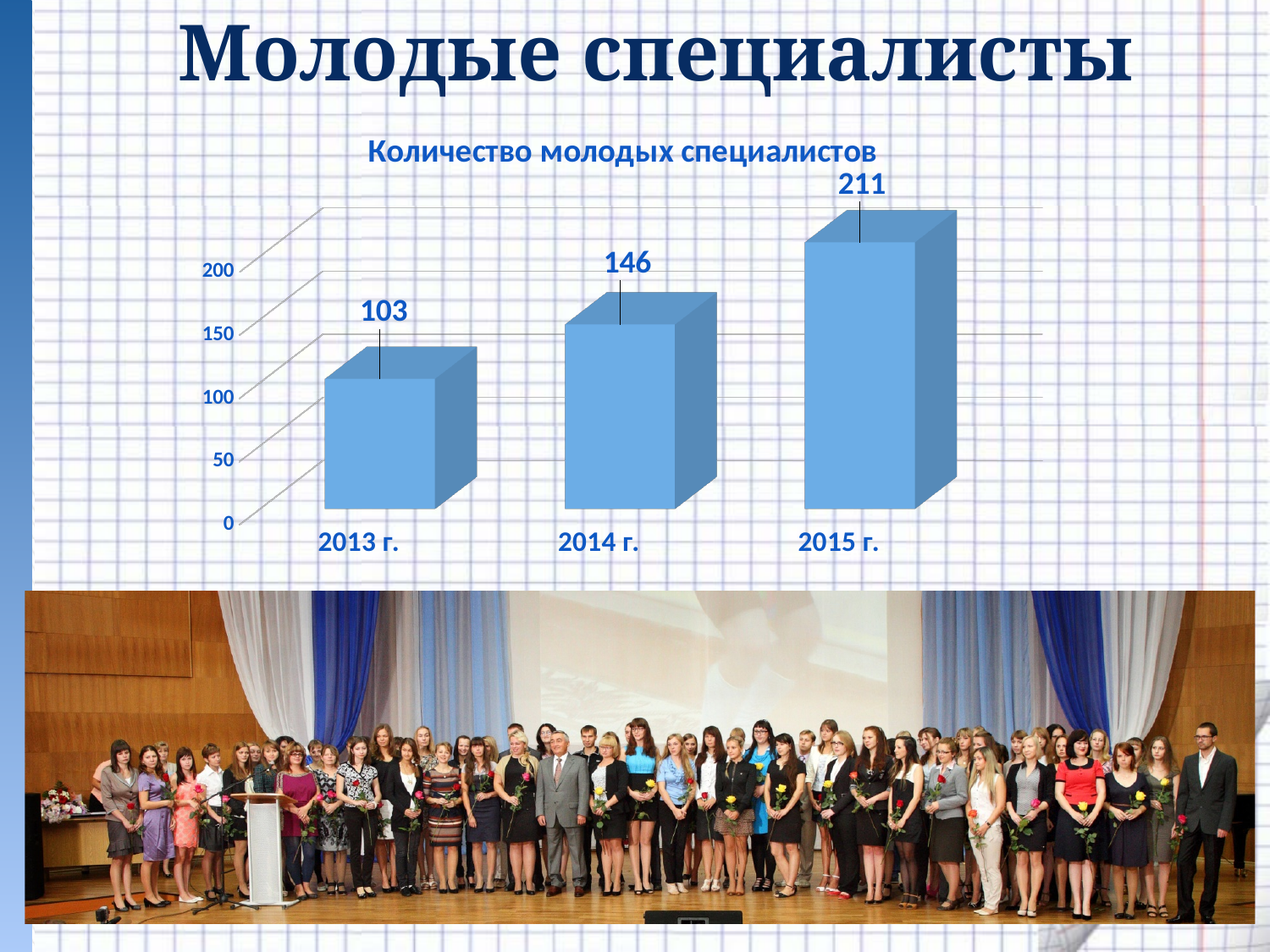
Do the values rise or fall from 2013 г. to 2015 г.? rise What is the difference between the values for 2014 г. and 2013 г.? 43 What kind of chart is shown on the slide? bar chart What is the value for 2013 г.? 103 Which year has the highest number of young specialists? 2015 г. What is the value for 2014 г.? 146 Which is larger, the value for 2014 г. or the value for 2013 г.? 2014 г. How many categories are shown on the x axis? 3 Is the value for 2015 г. greater or less than 200? greater What is the difference between the values for 2015 г. and 2014 г.? 65 What is the value for 2015 г.? 211 Which year has the lowest number of young specialists? 2013 г.